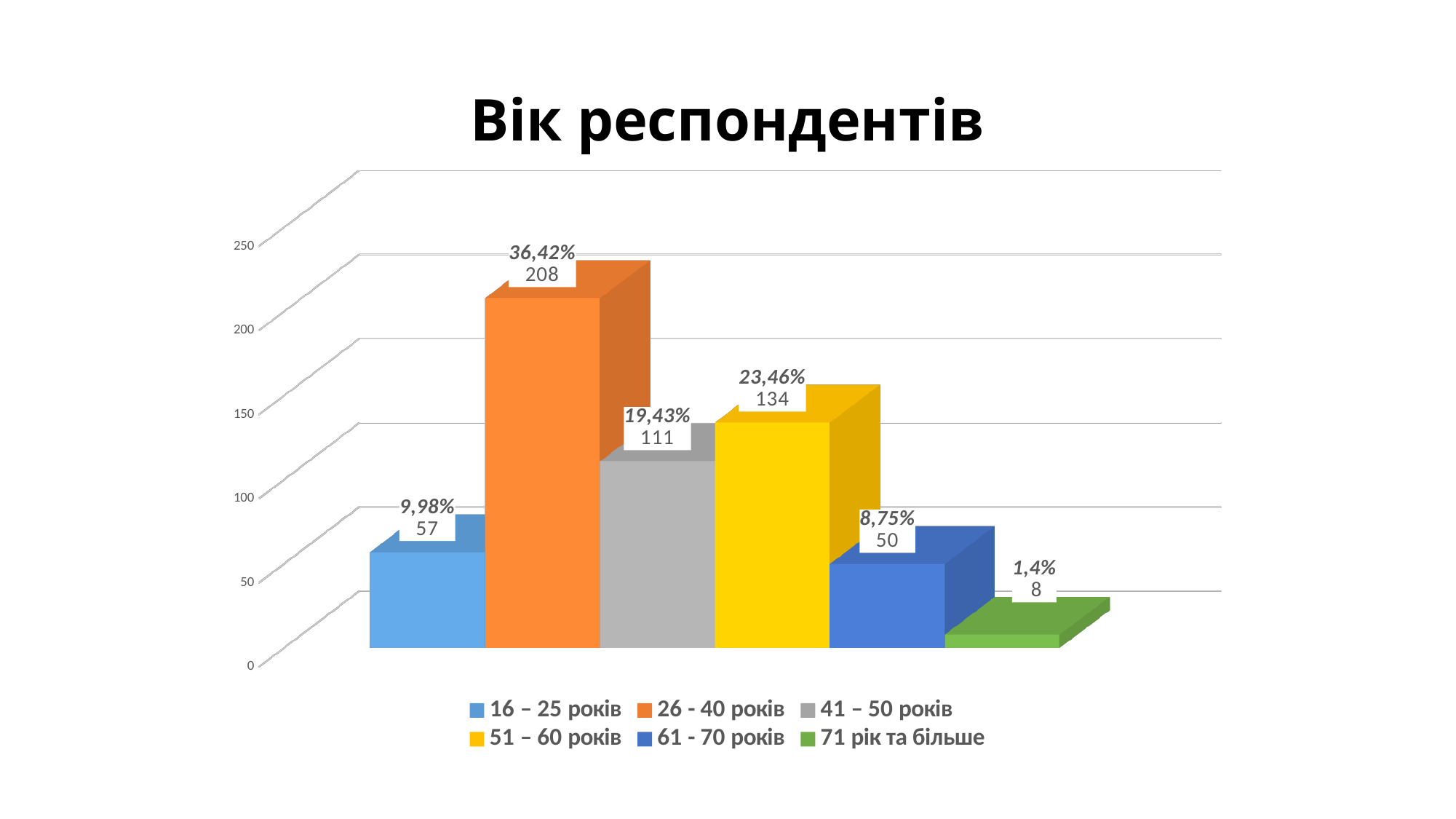
What type of chart is shown on the slide? bar chart Which group has more respondents, 16 – 25 років or 61 - 70 років? 16 – 25 років What percentage is shown for the 51 – 60 років group? 23,46% Which age group has the lowest number of respondents? 71 рік та більше How many entries does the legend list? 6 Which age group has the highest number of respondents? 26 - 40 років How many age groups are plotted in the chart? 6 What percentage is shown for the 61 - 70 років group? 8,75% What is the difference in respondents between the 26 - 40 років group and the 41 – 50 років group? 97 What is the number of respondents in the 71 рік та більше group? 8 What is the number of respondents in the 26 - 40 років group? 208 What is the title of the chart? Вік респондентів